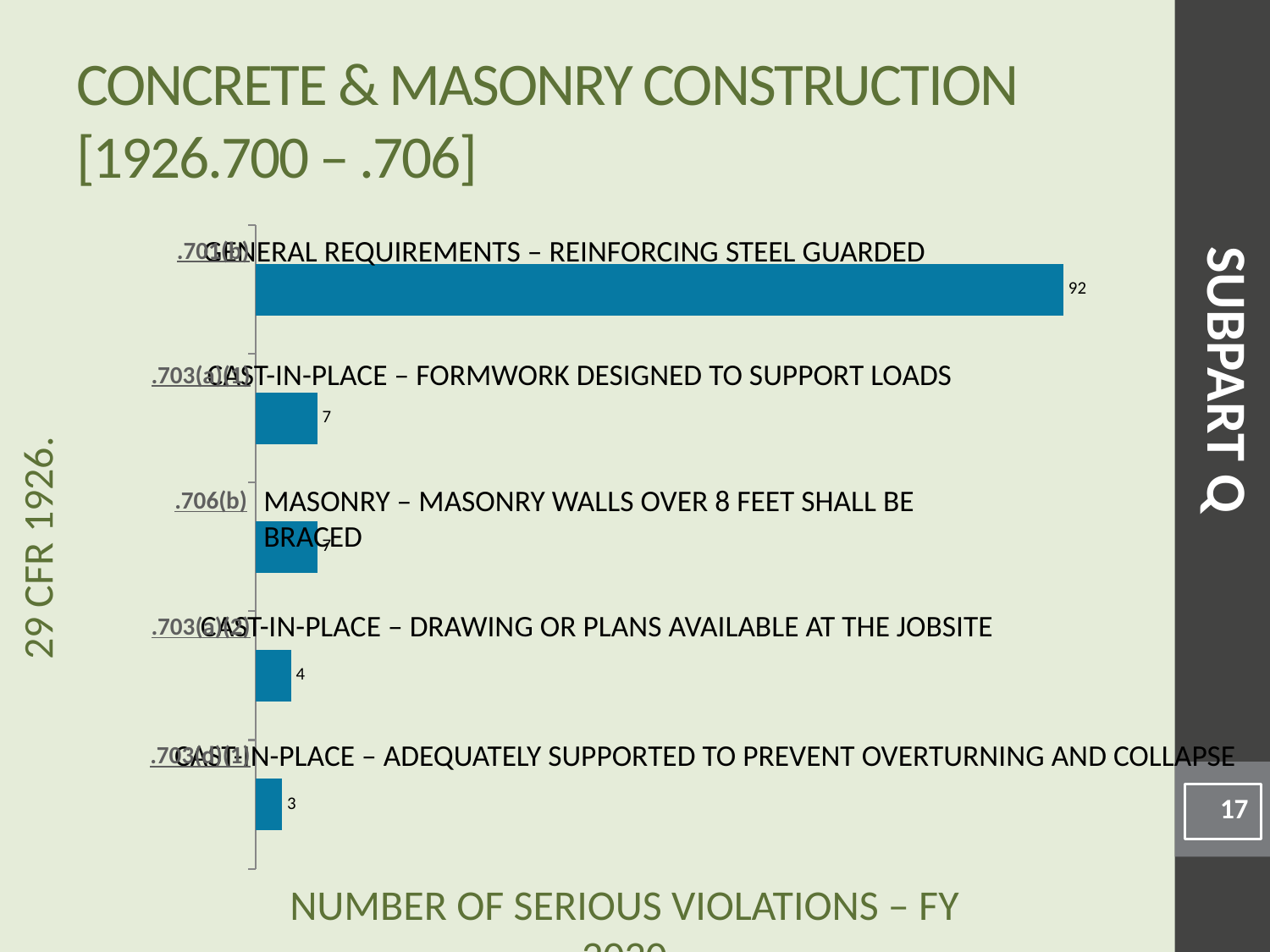
What is the difference in serious violations between Cast-in-Place – Drawing or Plans Available at the Jobsite and Cast-in-Place – Adequately Supported to Prevent Overturning and Collapse? 1 What is the number of serious violations for Cast-in-Place – Adequately Supported to Prevent Overturning and Collapse? 3 Which has more serious violations: Cast-in-Place – Drawing or Plans Available at the Jobsite or Cast-in-Place – Adequately Supported to Prevent Overturning and Collapse? Cast-in-Place – Drawing or Plans Available at the Jobsite What type of chart is shown on the slide? Bar chart How many categories are shown in the chart? 5 What is the number of serious violations for General Requirements – Reinforcing Steel Guarded? 92 How many more serious violations does General Requirements – Reinforcing Steel Guarded have than Cast-in-Place – Formwork Designed to Support Loads? 85 What is the number of serious violations for Cast-in-Place – Formwork Designed to Support Loads? 7 Which category has the highest number of serious violations? General Requirements – Reinforcing Steel Guarded Which category has the lowest number of serious violations? Cast-in-Place – Adequately Supported to Prevent Overturning and Collapse What is the number of serious violations for Masonry – Masonry Walls Over 8 Feet Shall Be Braced (.706(b))? 7 What is the number of serious violations for Cast-in-Place – Drawing or Plans Available at the Jobsite? 4